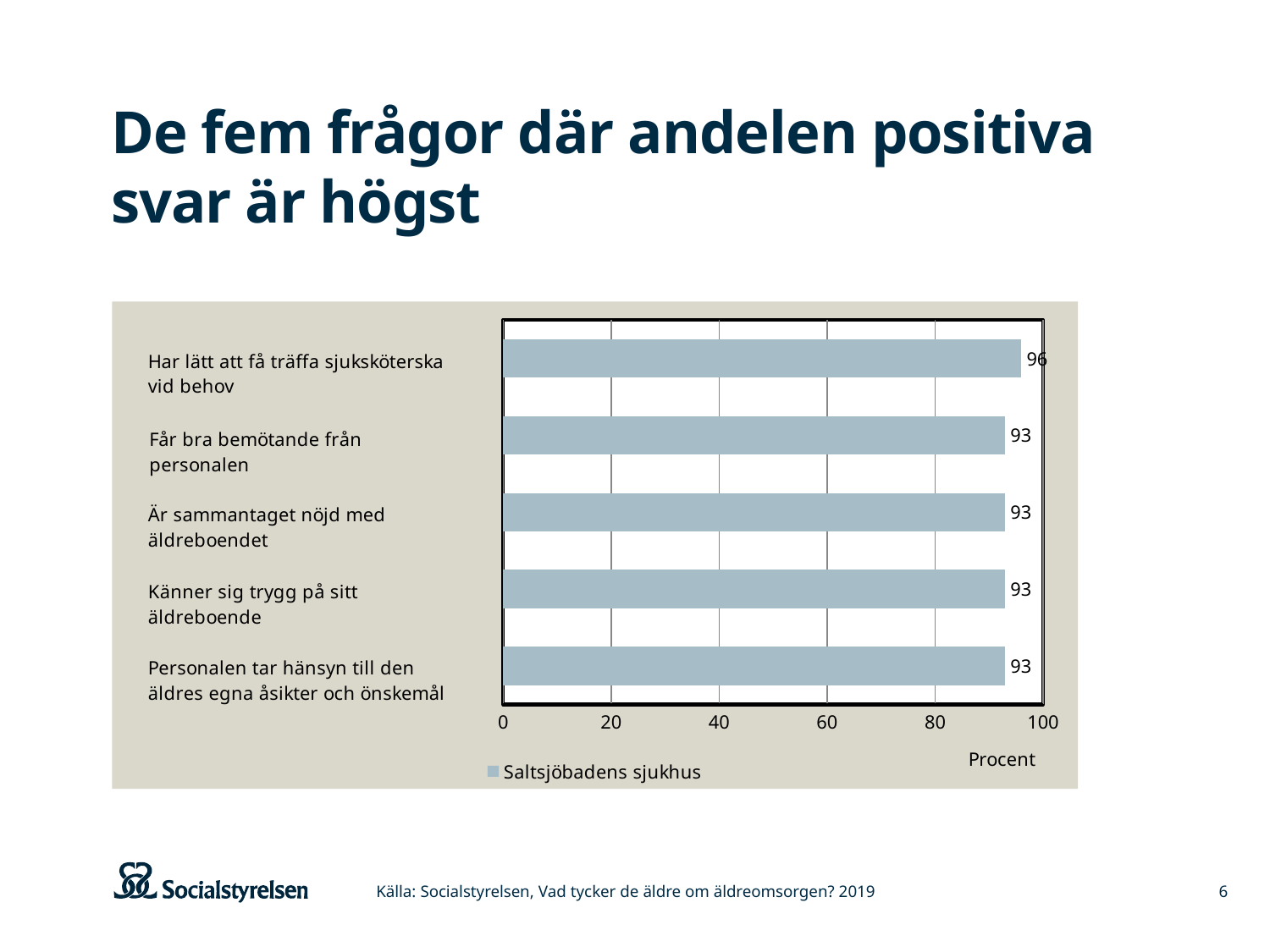
What is the difference between the value for "Har lätt att få träffa sjuksköterska vid behov" and the value for "Känner sig trygg på sitt äldreboende"? 3 What kind of chart is shown on the slide? bar chart Is the value for "Får bra bemötande från personalen" greater or less than 80? greater How many series does the legend list? 1 What is the value for "Har lätt att få träffa sjuksköterska vid behov"? 96 Which category has the highest value? Har lätt att få träffa sjuksköterska vid behov What is the value for "Personalen tar hänsyn till den äldres egna åsikter och önskemål"? 93 What is the label on the horizontal axis of the chart? Procent What is the value for "Får bra bemötande från personalen"? 93 How many categories are shown in the chart? 5 Which is larger: the value for "Har lätt att få träffa sjuksköterska vid behov" or the value for "Är sammantaget nöjd med äldreboendet"? Har lätt att få träffa sjuksköterska vid behov What series name is shown in the chart legend? Saltsjöbadens sjukhus